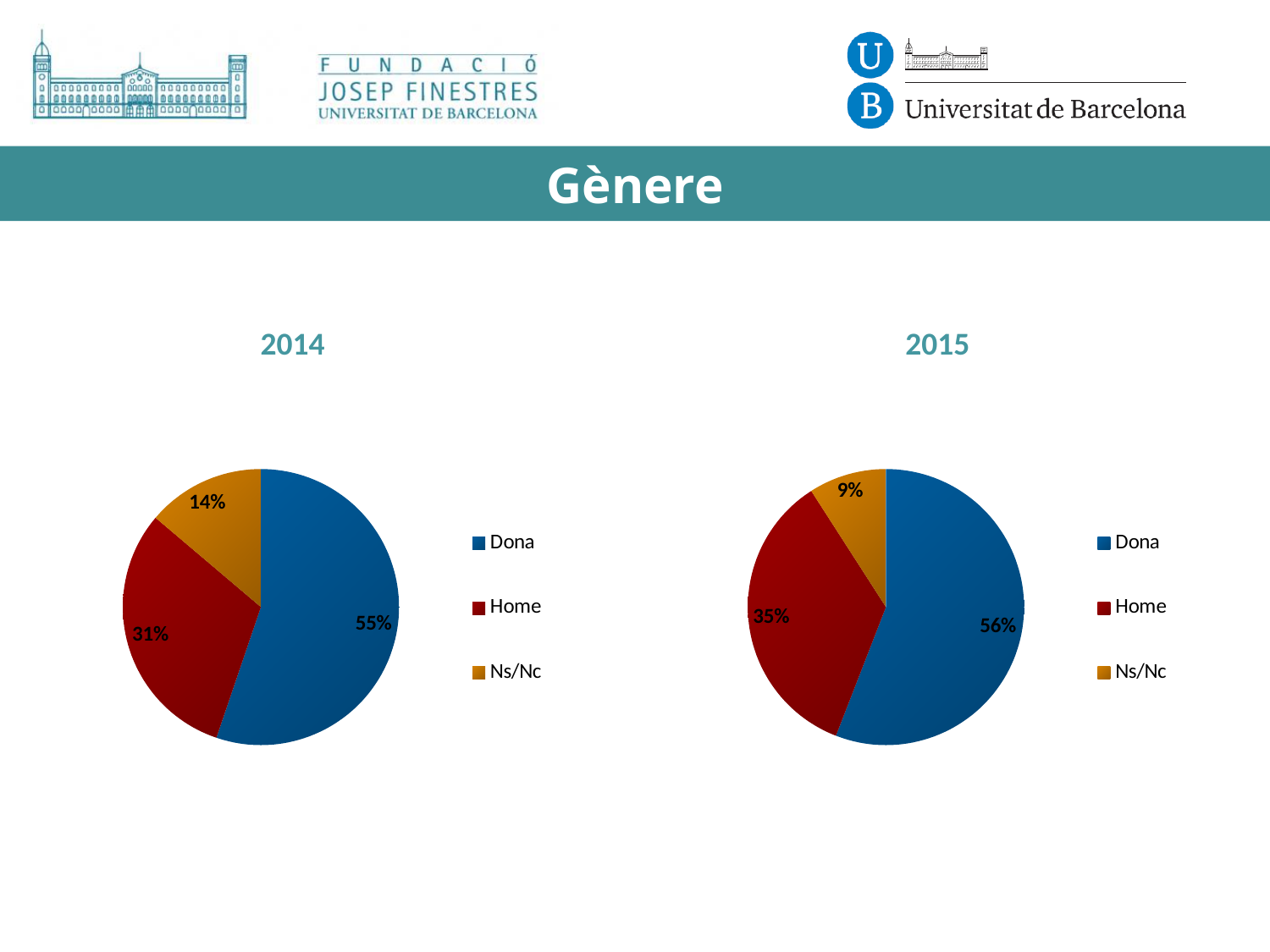
In the 2015 chart, what is the difference between the Dona and Home shares? 21% In the 2015 chart, what share does Home have? 35% In the 2014 chart, what share does Home have? 31% Which is larger in the 2014 chart, Home or Ns/Nc? Home In the 2014 chart, what share does Ns/Nc have? 14% In the 2014 chart, what share does Dona have? 55% In the 2015 chart, which category has the smallest slice? Ns/Nc In the 2014 chart, which category has the largest slice? Dona What kind of chart is the 2015 chart? Pie chart In the 2015 chart, what share does Ns/Nc have? 9% In the 2015 chart, what share does Dona have? 56% How many categories does the legend of the 2014 chart list? 3